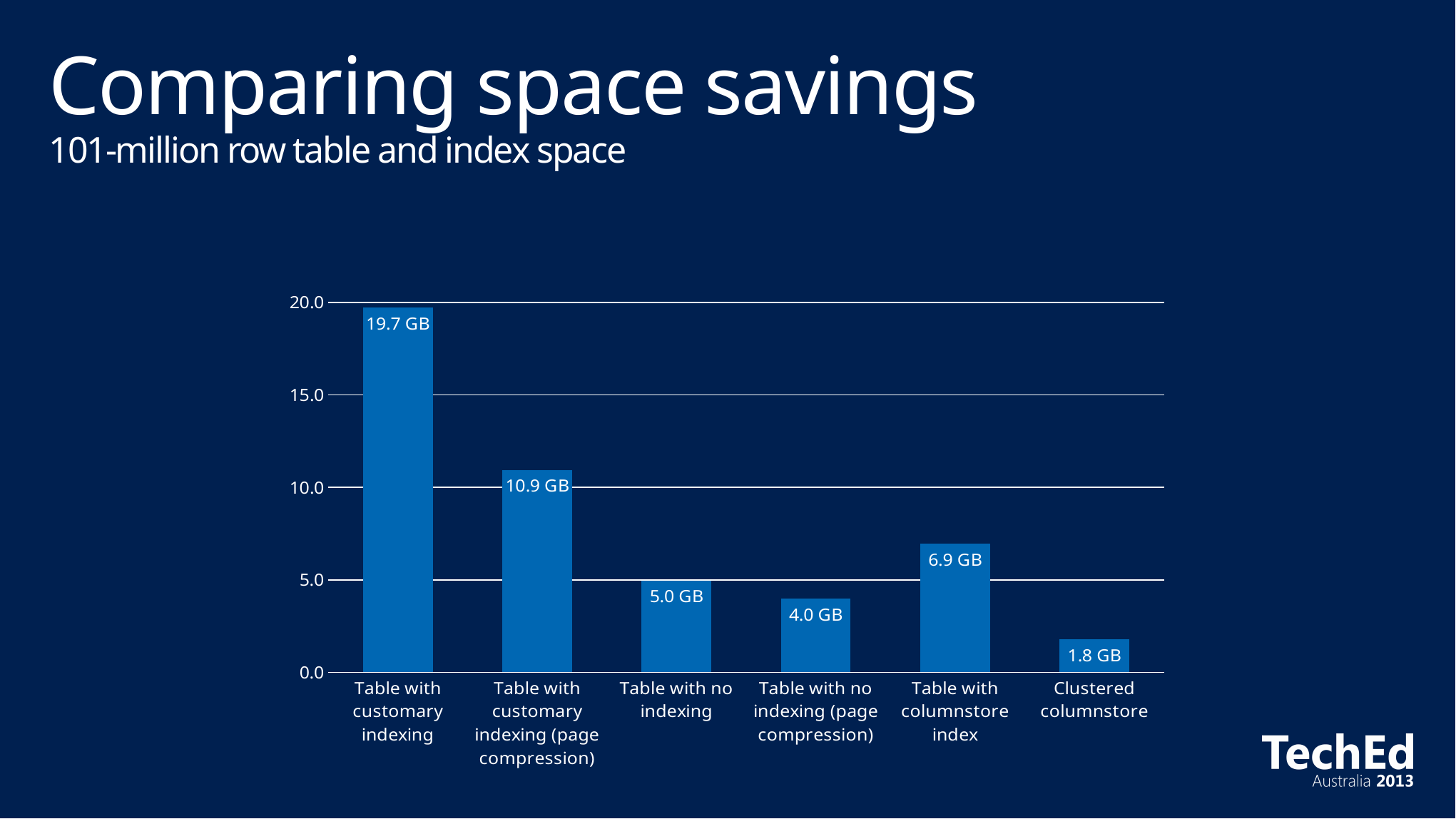
What is the difference between "Table with customary indexing" and "Table with customary indexing (page compression)"? 8.8 GB What is the subtitle of the slide below "Comparing space savings"? 101-million row table and index space What is the value for "Clustered columnstore"? 1.8 GB Which is larger: "Table with columnstore index" or "Table with no indexing"? Table with columnstore index What is the difference between "Table with no indexing" and "Table with no indexing (page compression)"? 1.0 GB What is the value for "Table with columnstore index"? 6.9 GB What kind of chart is shown on the slide? Bar chart What is the value for "Table with customary indexing"? 19.7 GB Is the value for "Table with customary indexing (page compression)" greater or less than 10.0? greater How many categories are shown on the chart? 6 Which category has the highest value? Table with customary indexing Which category has the lowest value? Clustered columnstore